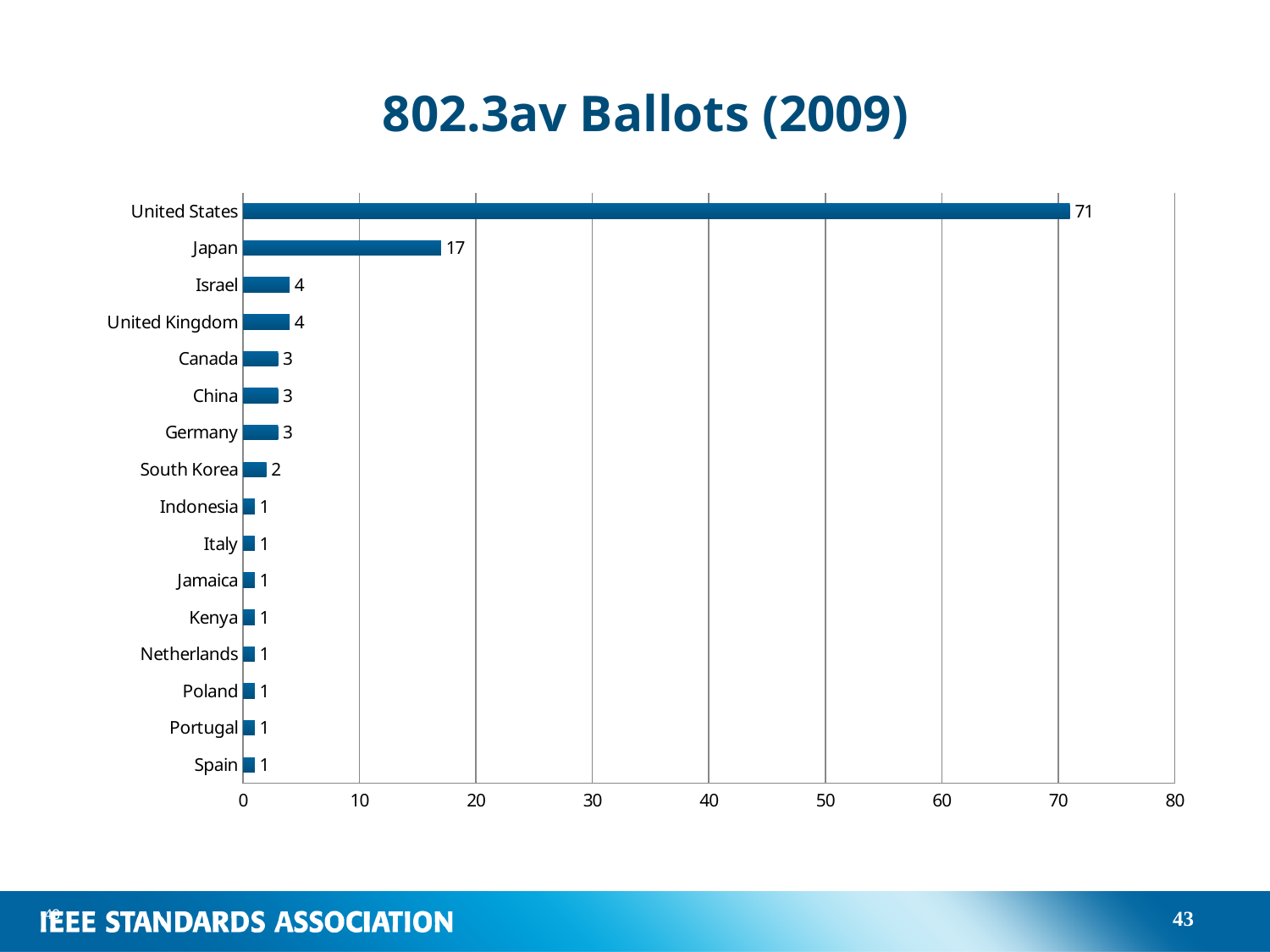
What is the title of the chart? 802.3av Ballots (2009) Which is larger, the value for Israel or the value for Canada? Israel How many countries are shown in the chart? 16 How many countries have a value of 1? 8 Which country has the highest number of ballots? United States Is the value for United States greater or less than 60? greater What is the difference between the values for United States and Japan? 54 What is the value for South Korea? 2 What is the value for Germany? 3 What is the value for United States? 71 What kind of chart is shown on the slide? bar chart What is the value for Japan? 17